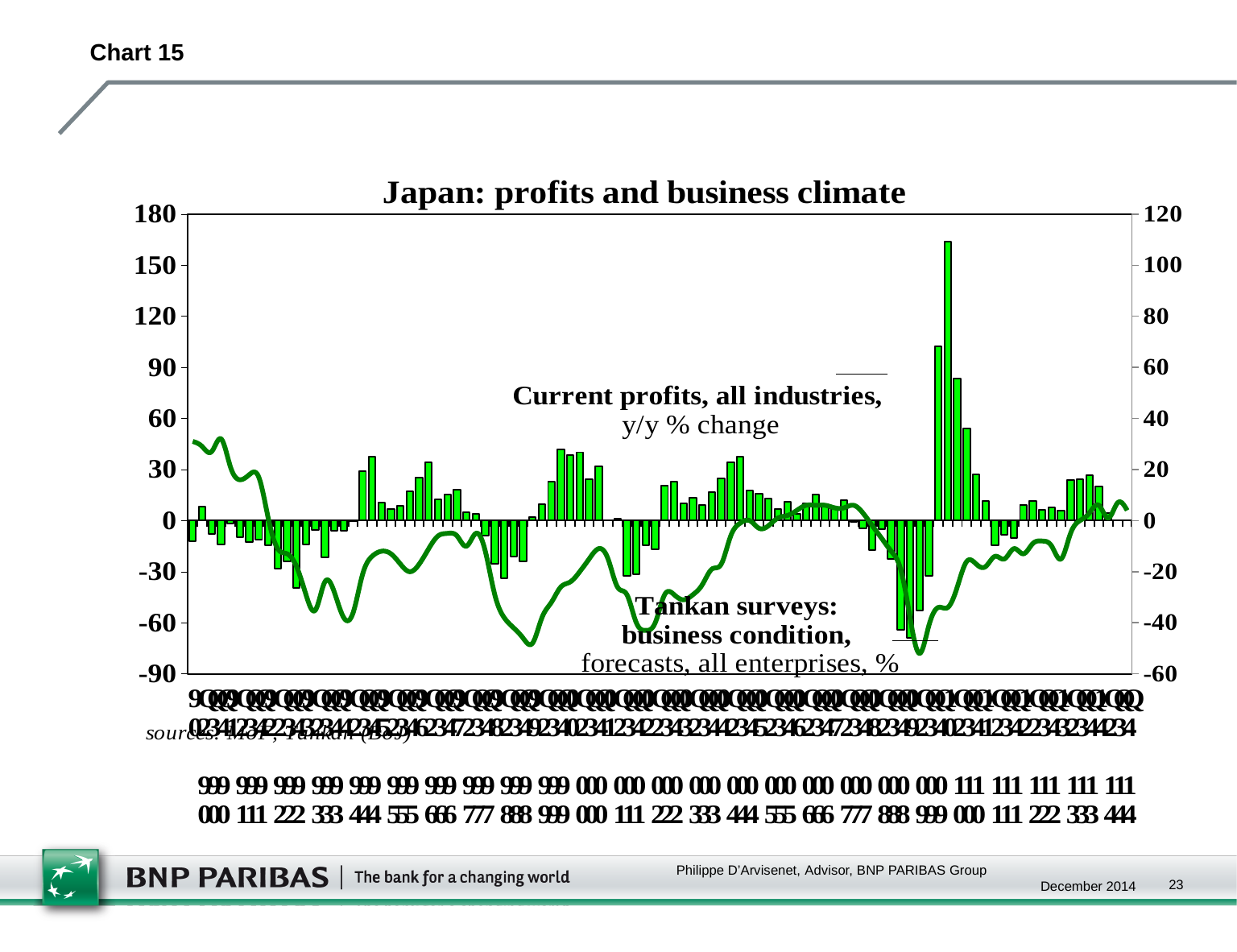
Is the highest point of the Tankan surveys line greater or less than 20 on the right axis? greater Is the value of the tallest bar (current profits) greater or less than 150 on the left axis? greater What kind of chart is this? Combined bar and line chart How many data series are plotted on the chart? 2 Which series is plotted as bars? Current profits, all industries, y/y % change What is the title of the chart? Japan: profits and business climate Does the Tankan surveys line rise or fall over the first years of the chart, from 1990 to 1993? fall Is the value of the lowest bar (current profits) greater or less than -30 on the left axis? less